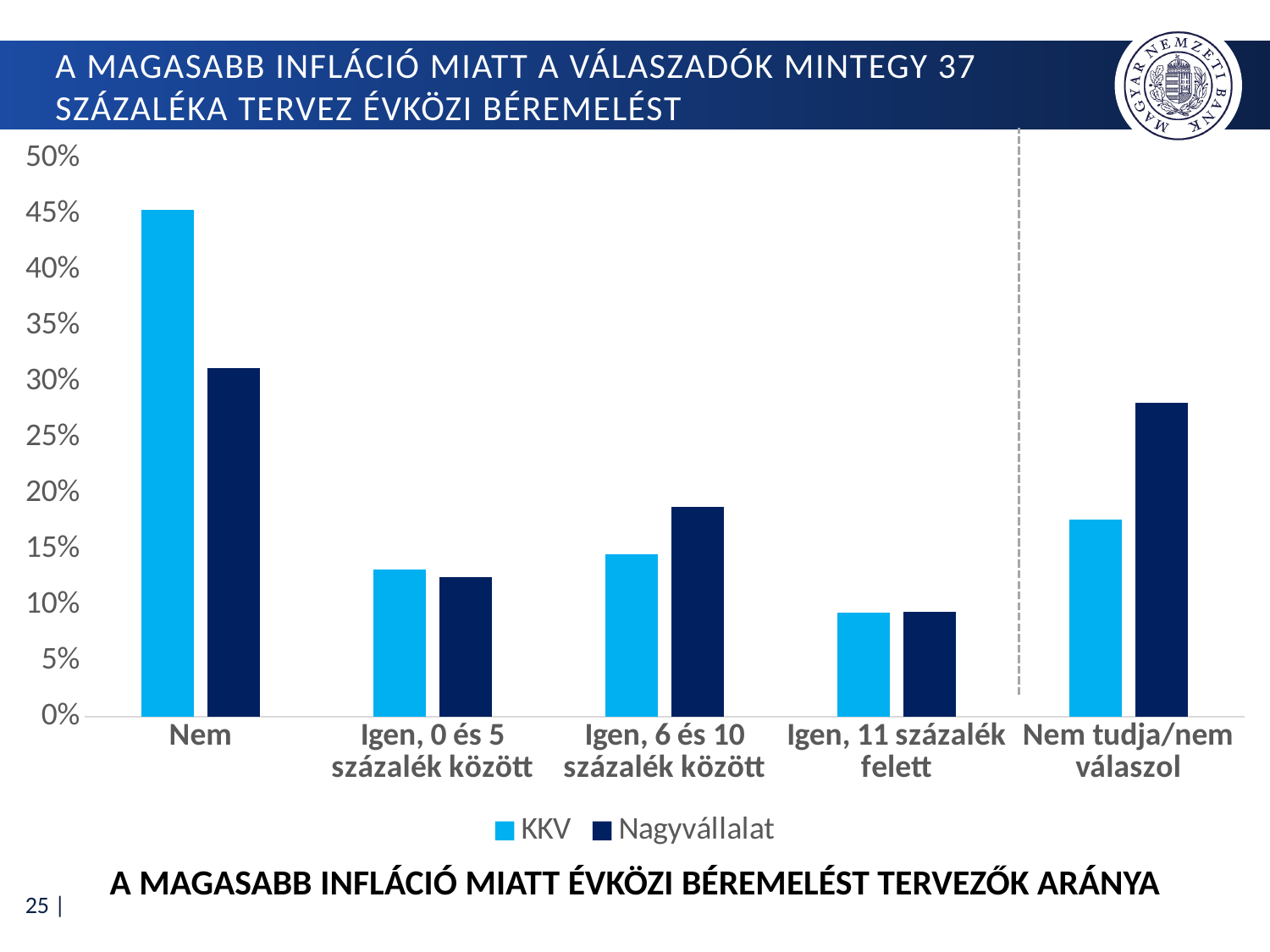
Is the KKV value for Nem greater or less than 40%? greater Which category has the lowest Nagyvállalat value? Igen, 11 százalék felett Is the Nagyvállalat value for Nem tudja/nem válaszol greater or less than 25%? greater Which category has the highest KKV value? Nem Which category has the highest Nagyvállalat value? Nem For Nem tudja/nem válaszol, which series has the larger value, KKV or Nagyvállalat? Nagyvállalat How many series does the legend list? 2 How many categories are shown on the x axis? 5 Which category has the lowest KKV value? Igen, 11 százalék felett What kind of chart is shown on the slide? bar chart What are the two series named in the legend? KKV and Nagyvállalat Is the KKV value for Igen, 11 százalék felett greater or less than 10%? less